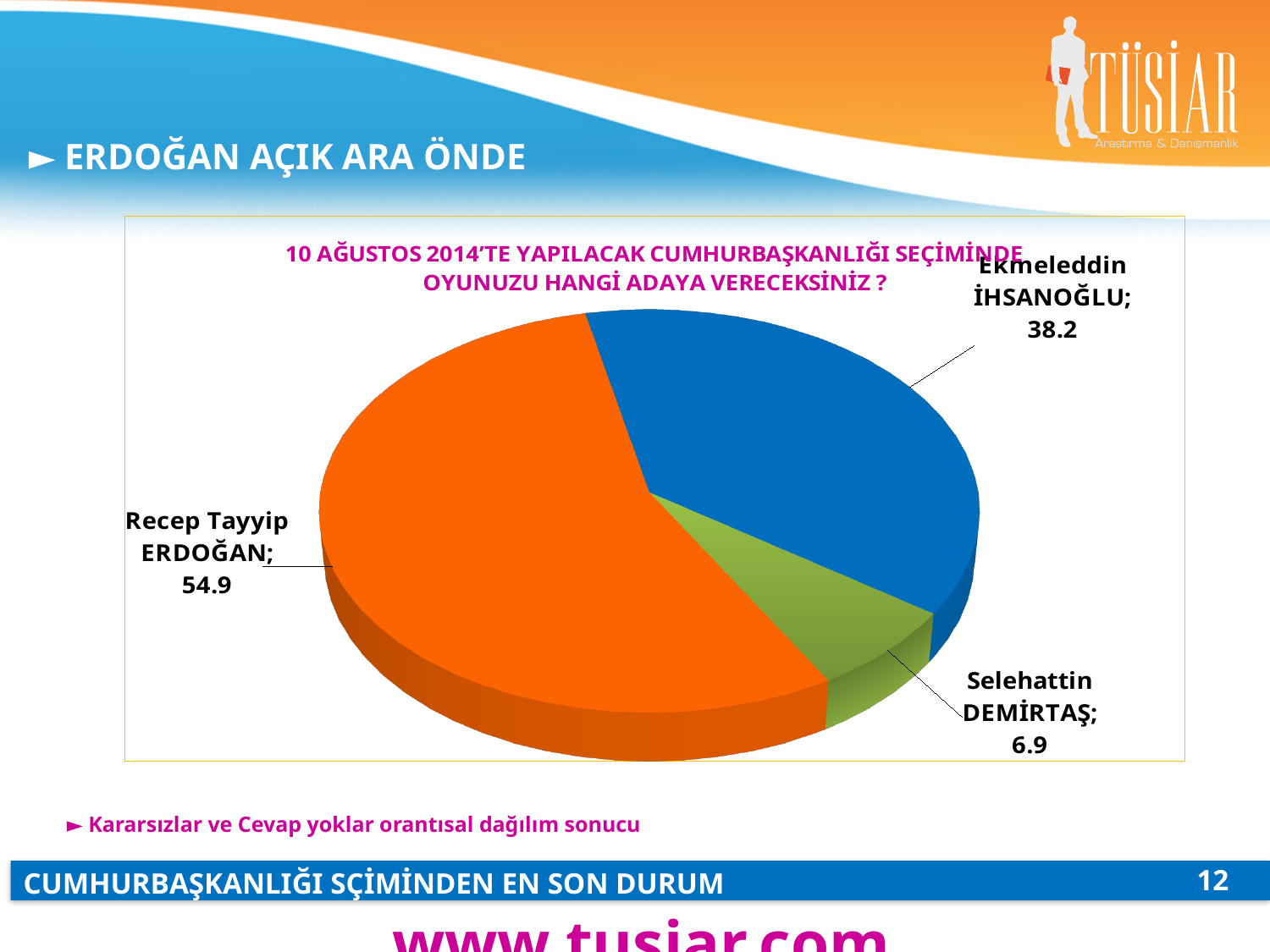
What is the difference between the values for Recep Tayyip ERDOĞAN and Ekmeleddin İHSANOĞLU? 16.7 What colour is the slice for Recep Tayyip ERDOĞAN? orange How many candidates (slices) are shown in the pie chart? 3 What is the value shown for Ekmeleddin İHSANOĞLU? 38.2 What is the value shown for Recep Tayyip ERDOĞAN? 54.9 What is the total of the three values shown in the pie chart? 100 Which candidate has the largest slice of the pie? Recep Tayyip ERDOĞAN What is the value shown for Selehattin DEMİRTAŞ? 6.9 Which candidate has the smallest slice of the pie? Selehattin DEMİRTAŞ What type of chart is shown on the slide? pie chart Which is larger, the value for Ekmeleddin İHSANOĞLU or the value for Selehattin DEMİRTAŞ? Ekmeleddin İHSANOĞLU What is the difference between the values for Ekmeleddin İHSANOĞLU and Selehattin DEMİRTAŞ? 31.3